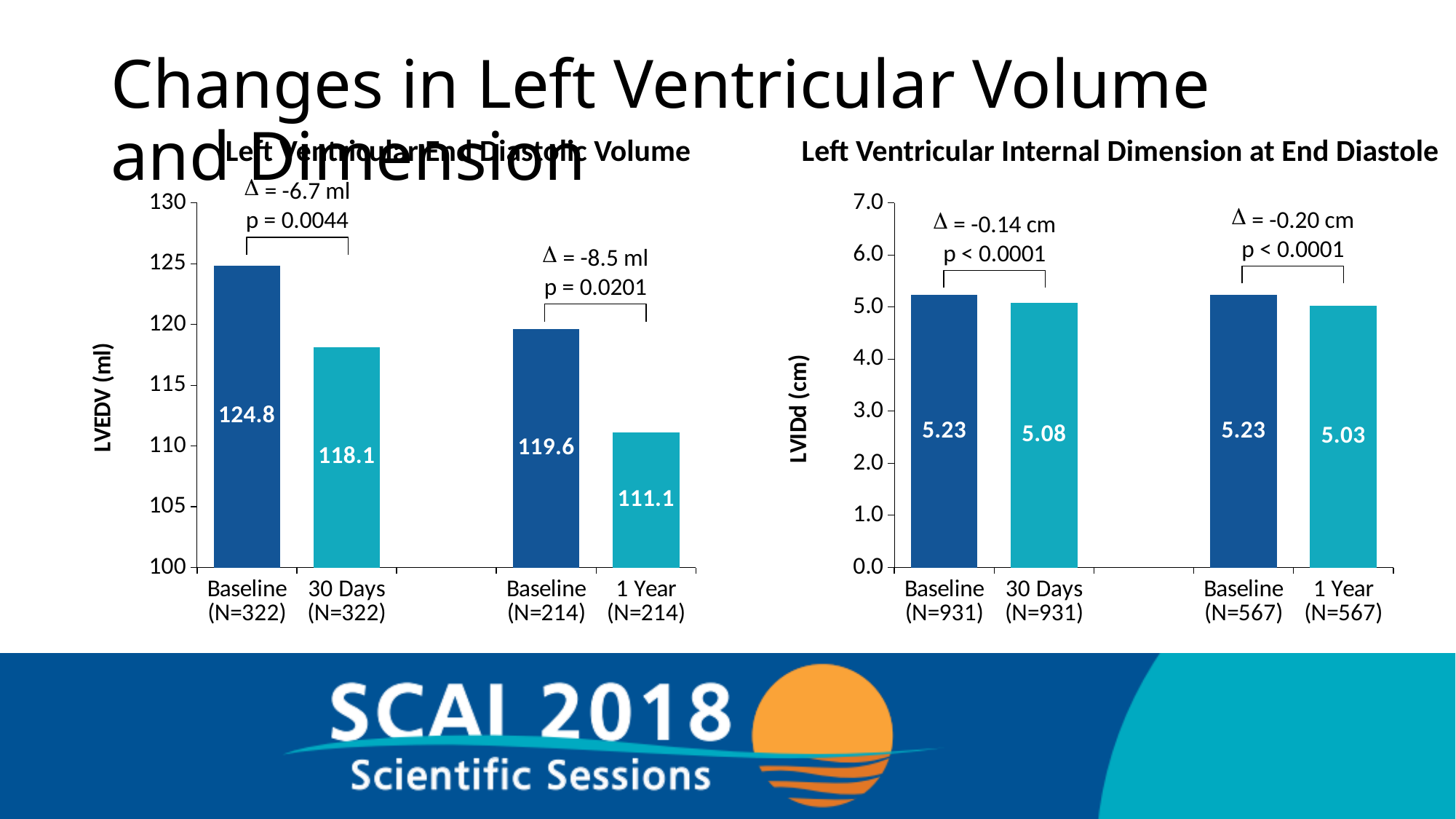
What type of chart is used for the Left Ventricular End Diastolic Volume data on the left? Bar chart In the right chart (Left Ventricular Internal Dimension at End Diastole), what is the LVIDd value at 1 Year (N=567)? 5.03 In the left chart (Left Ventricular End Diastolic Volume), what is the LVEDV value at 1 Year (N=214)? 111.1 In the right chart (Left Ventricular Internal Dimension at End Diastole), what is the LVIDd value at 30 Days (N=931)? 5.08 How many bars are plotted in the right chart (Left Ventricular Internal Dimension at End Diastole)? 4 In the left chart (Left Ventricular End Diastolic Volume), what is the LVEDV value for Baseline (N=322)? 124.8 In the right chart (Left Ventricular Internal Dimension at End Diastole), which bar has the lowest value? 1 Year (N=567) In the left chart (Left Ventricular End Diastolic Volume), is the value for 30 Days (N=322) greater or less than 120? less In the left chart (Left Ventricular End Diastolic Volume), what is the difference between the Baseline (N=322) value and the 30 Days (N=322) value? 6.7 In the left chart (Left Ventricular End Diastolic Volume), which bar has the lowest value? 1 Year (N=214) In the right chart (Left Ventricular Internal Dimension at End Diastole), which is larger: the 30 Days (N=931) value or the 1 Year (N=567) value? 30 Days (N=931) In the left chart (Left Ventricular End Diastolic Volume), which bar has the highest value? Baseline (N=322)